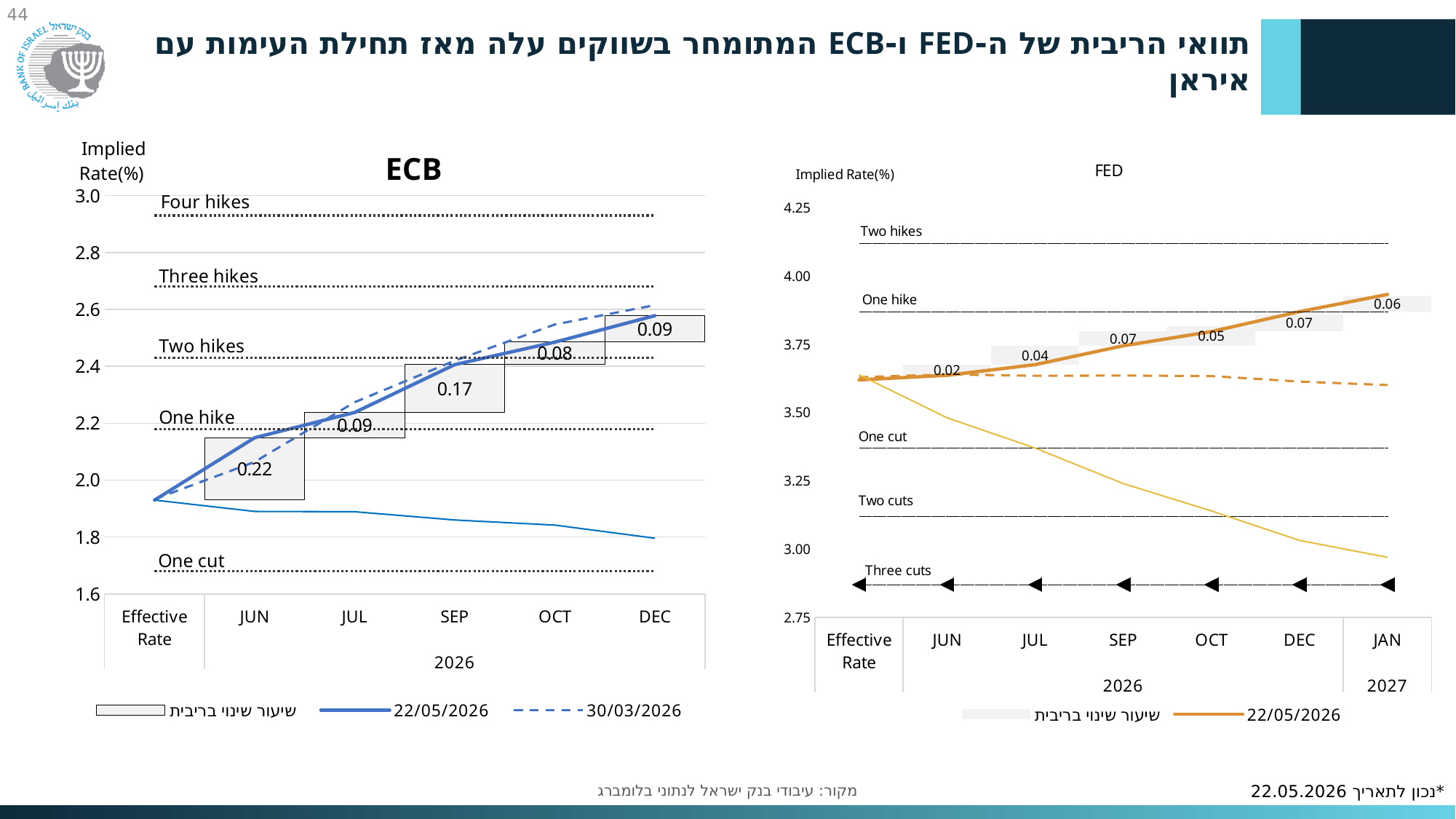
In the FED chart, is the labelled rate change for SEP larger or smaller than the one for OCT? larger In the ECB chart, which month has the smallest labelled rate change? OCT In the FED chart, what is the rate change value shown for JAN 2027? 0.06 In the ECB chart, what is the rate change value shown for SEP? 0.17 How many entries does the legend of the ECB chart list? 3 In the FED chart, what is the rate change value shown for JUL? 0.04 In the ECB chart, does the 22/05/2026 implied rate line rise or fall from the Effective Rate to DEC? rise In the FED chart, is the 22/05/2026 implied rate at DEC greater or less than 3.75? greater In the ECB chart, which month has the largest labelled rate change? JUN In the ECB chart, what is the rate change value shown for JUN? 0.22 In the ECB chart, what is the difference between the rate change for JUN and the rate change for SEP? 0.05 In the FED chart, which month has the smallest labelled rate change? JUN